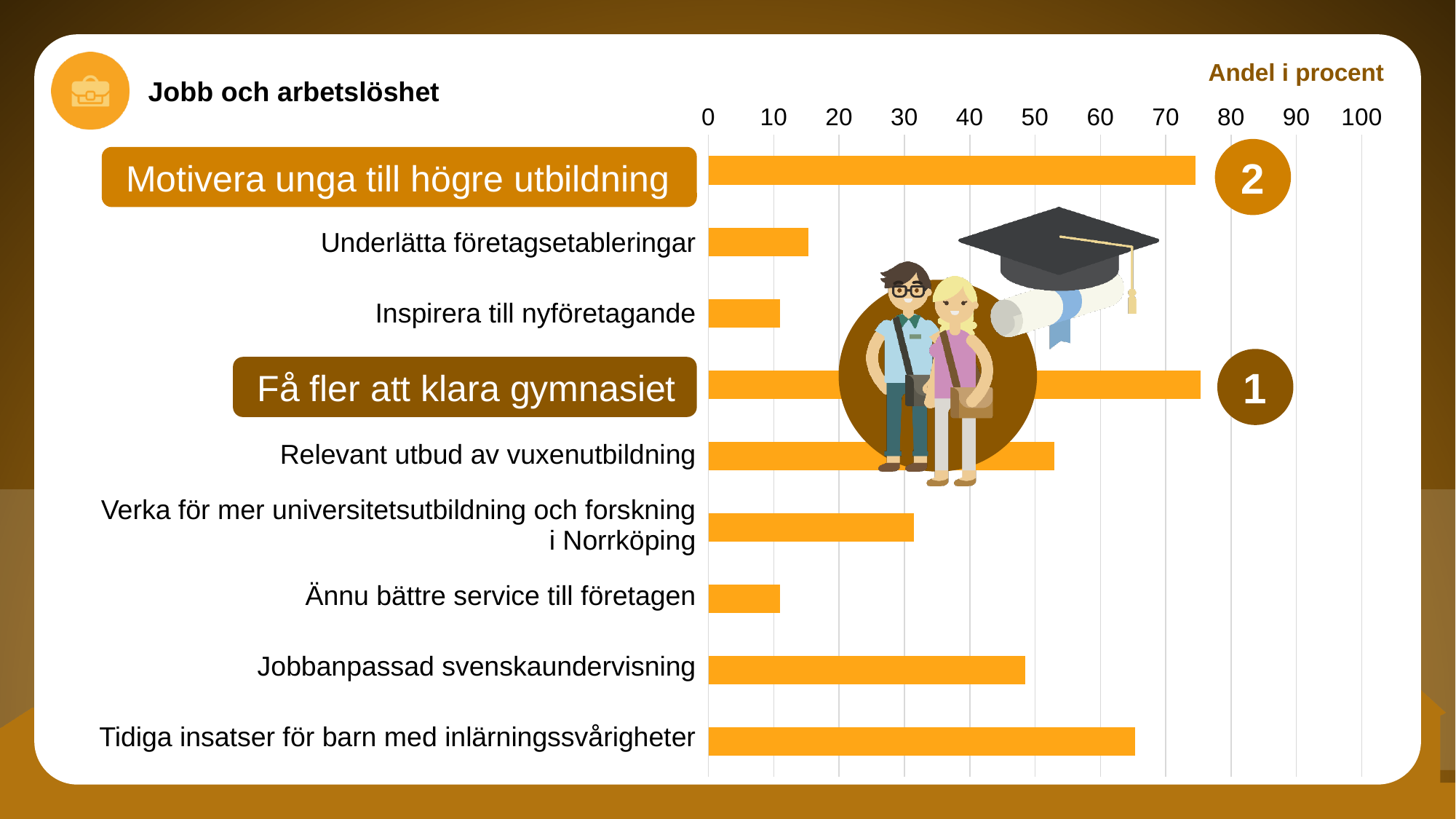
Is the value for "Verka för mer universitetsutbildning och forskning i Norrköping" greater or less than 40? less Is the value for "Underlätta företagsetableringar" greater or less than 20? less Is the value for "Motivera unga till högre utbildning" greater or less than 70? greater Which has the larger value: "Tidiga insatser för barn med inlärningssvårigheter" or "Relevant utbud av vuxenutbildning"? Tidiga insatser för barn med inlärningssvårigheter Which category is marked with the number 1 on the slide? Få fler att klara gymnasiet Which has the larger value: "Underlätta företagsetableringar" or "Verka för mer universitetsutbildning och forskning i Norrköping"? Verka för mer universitetsutbildning och forskning i Norrköping What kind of chart is shown on the slide? bar chart How many categories are plotted in the chart? 9 What is the label shown above the chart's horizontal axis? Andel i procent